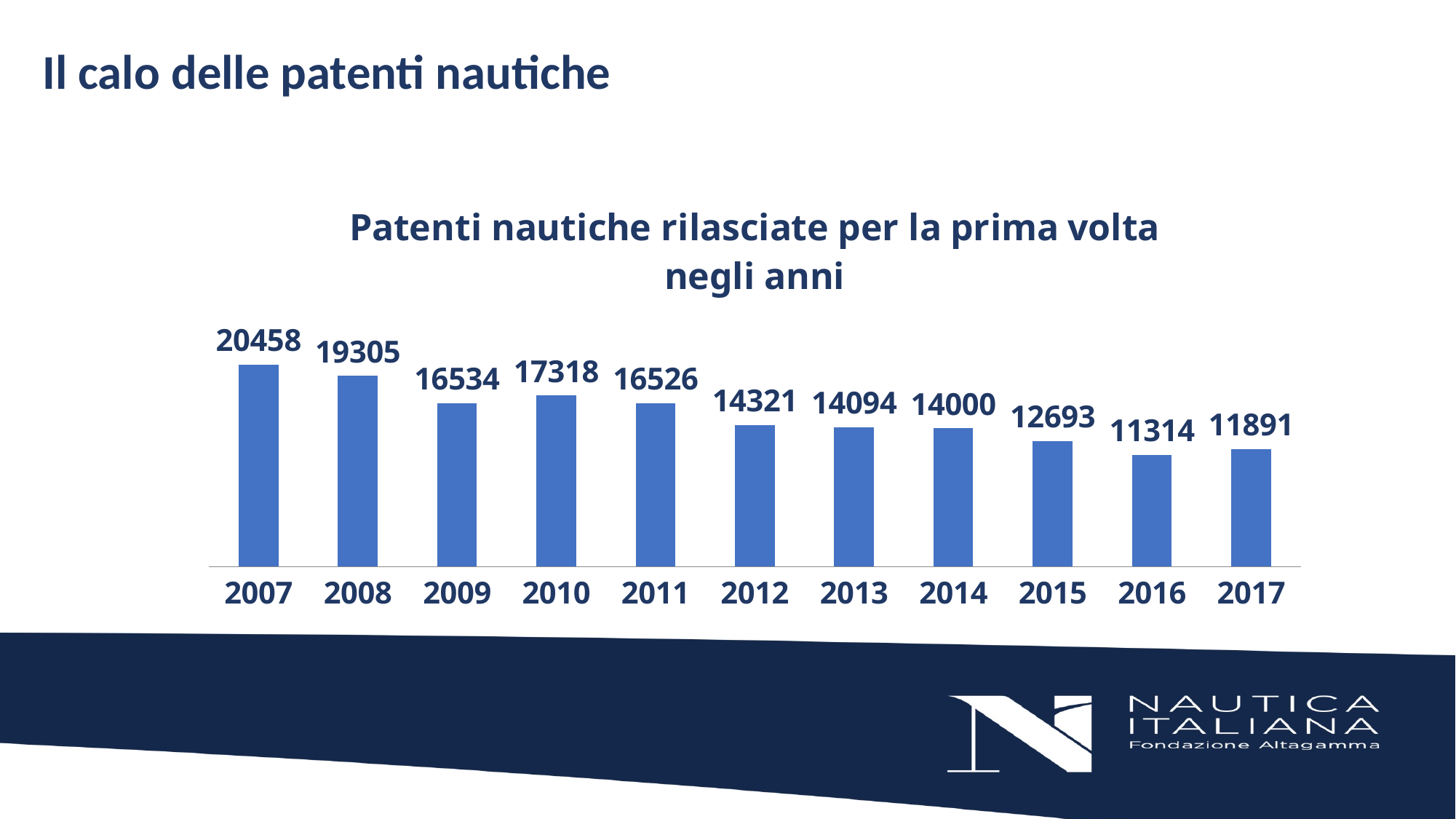
What is the value for 2016? 11314 Which is larger, the value for 2010 or the value for 2011? 2010 What is the difference between the values for 2009 and 2010? 784 Which is larger, the value for 2016 or the value for 2017? 2017 Which year has the highest value? 2007 What kind of chart is this? bar chart Which year has the lowest value? 2016 What is the value for 2007? 20458 What is the title of the chart? Patenti nautiche rilasciate per la prima volta negli anni How many years are shown on the x axis? 11 What is the difference between the values for 2007 and 2017? 8567 What is the value for 2012? 14321